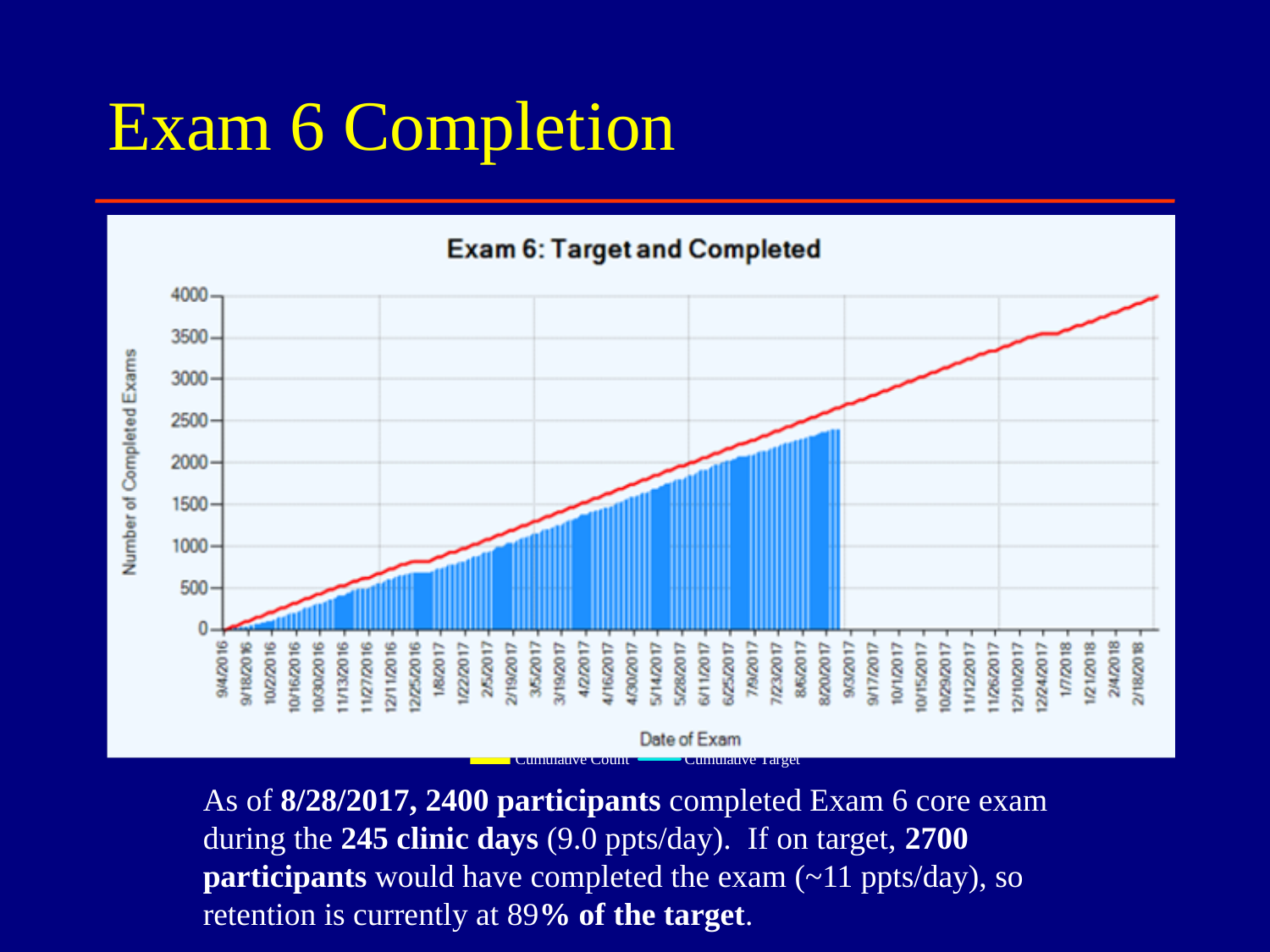
How many series does the chart's legend list? 2 Is the Cumulative Target value at 11/13/2016 greater or less than 1000? less What kind of chart is shown on the slide? A bar chart with a line overlay Is the Cumulative Count value at 8/20/2017 greater or less than 2000? greater What is the title of the chart? Exam 6: Target and Completed Is the Cumulative Count value at 1/8/2017 greater or less than 1000? less Do the Cumulative Count bars rise or fall along the x axis? Rise What is the label of the y axis? Number of Completed Exams At 8/20/2017, which is larger: the Cumulative Target or the Cumulative Count? Cumulative Target